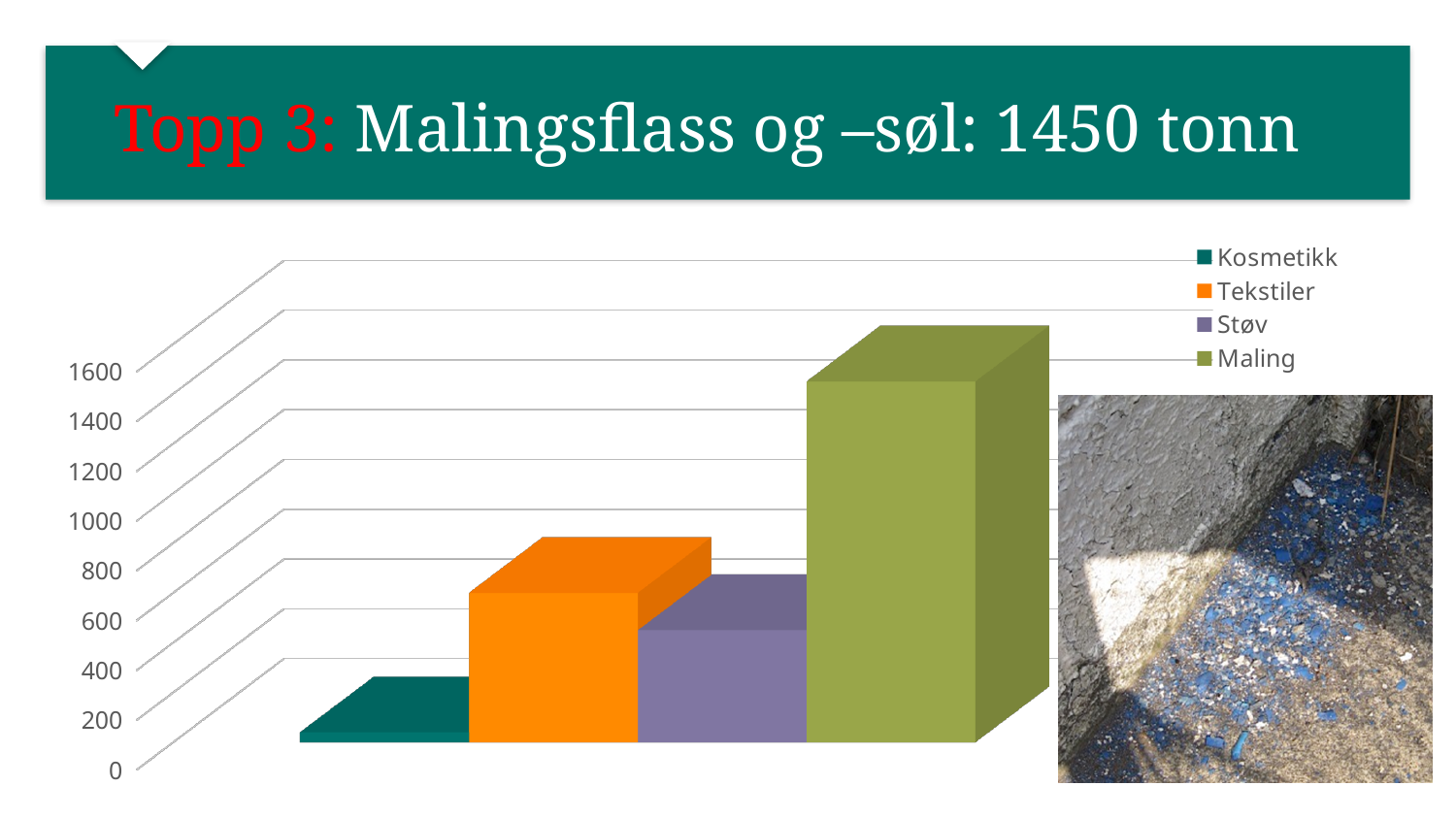
Which series has the highest bar in the chart? Maling Which series is listed first in the chart legend? Kosmetikk Is the value for Maling greater or less than 1000? greater How many series does the chart legend list? 4 Is the value for Støv greater or less than 800? less What colour is the Tekstiler series in the chart legend? orange Is the value for Tekstiler greater or less than 400? greater Which series has the lowest bar in the chart? Kosmetikk What kind of chart is shown on the slide? bar chart Which is larger, the bar for Tekstiler or the bar for Støv? Tekstiler How many bars are plotted in the chart? 4